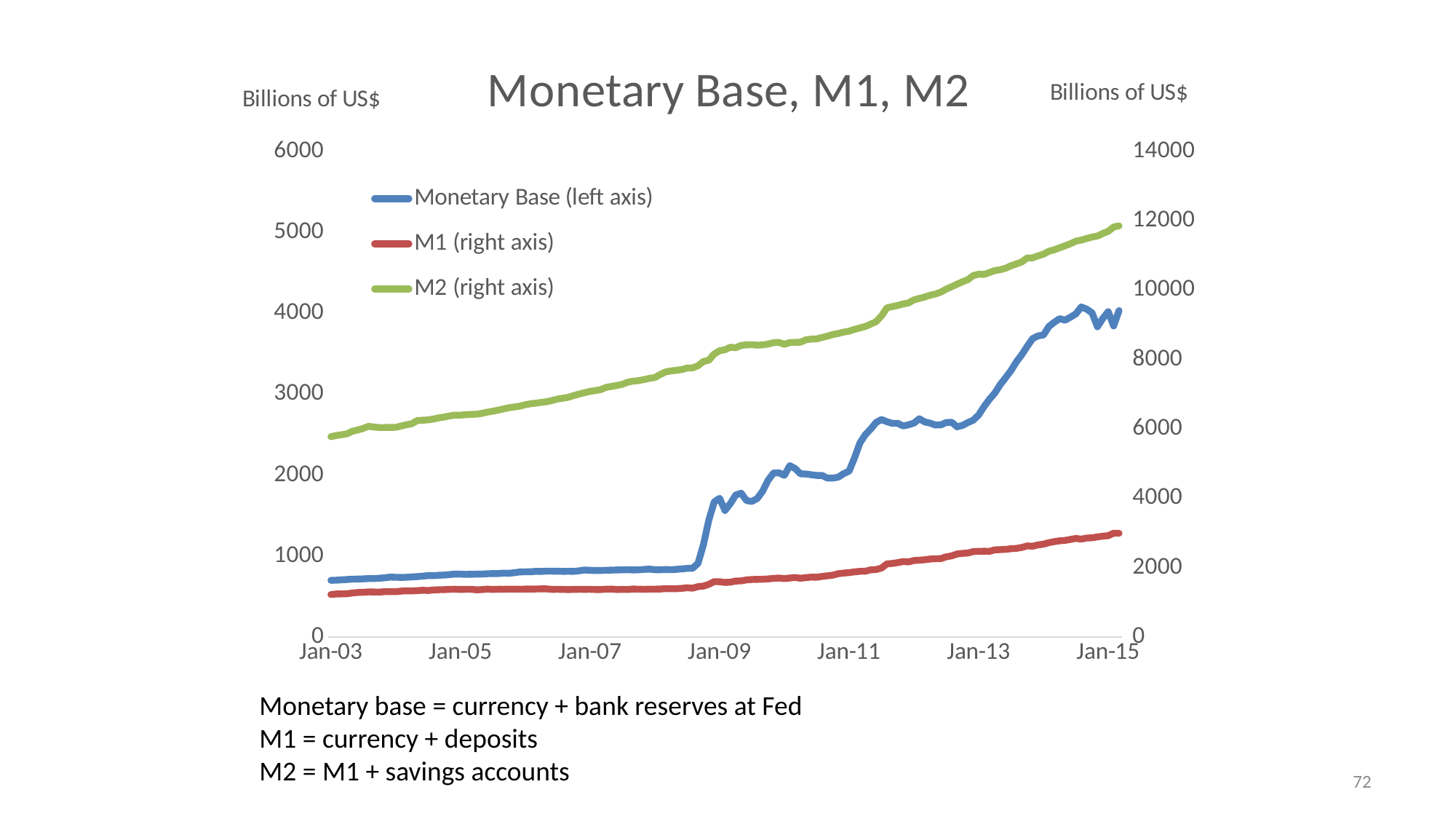
Which series is plotted against the left axis? Monetary Base Is the M1 value at Jan-03 greater or less than 2000 on the right axis? less Is the M2 value at Jan-15 greater or less than 10000 on the right axis? greater Is the Monetary Base value at Jan-15 greater or less than 3000 on the left axis? greater How many series does the legend list? 3 What kind of chart is shown on the slide? line chart What is the title of the chart? Monetary Base, M1, M2 On the right axis, which is larger at Jan-15: M1 or M2? M2 Does the M2 series rise or fall overall from Jan-03 to Jan-15? rise Does the Monetary Base series rise or fall overall from Jan-03 to Jan-15? rise